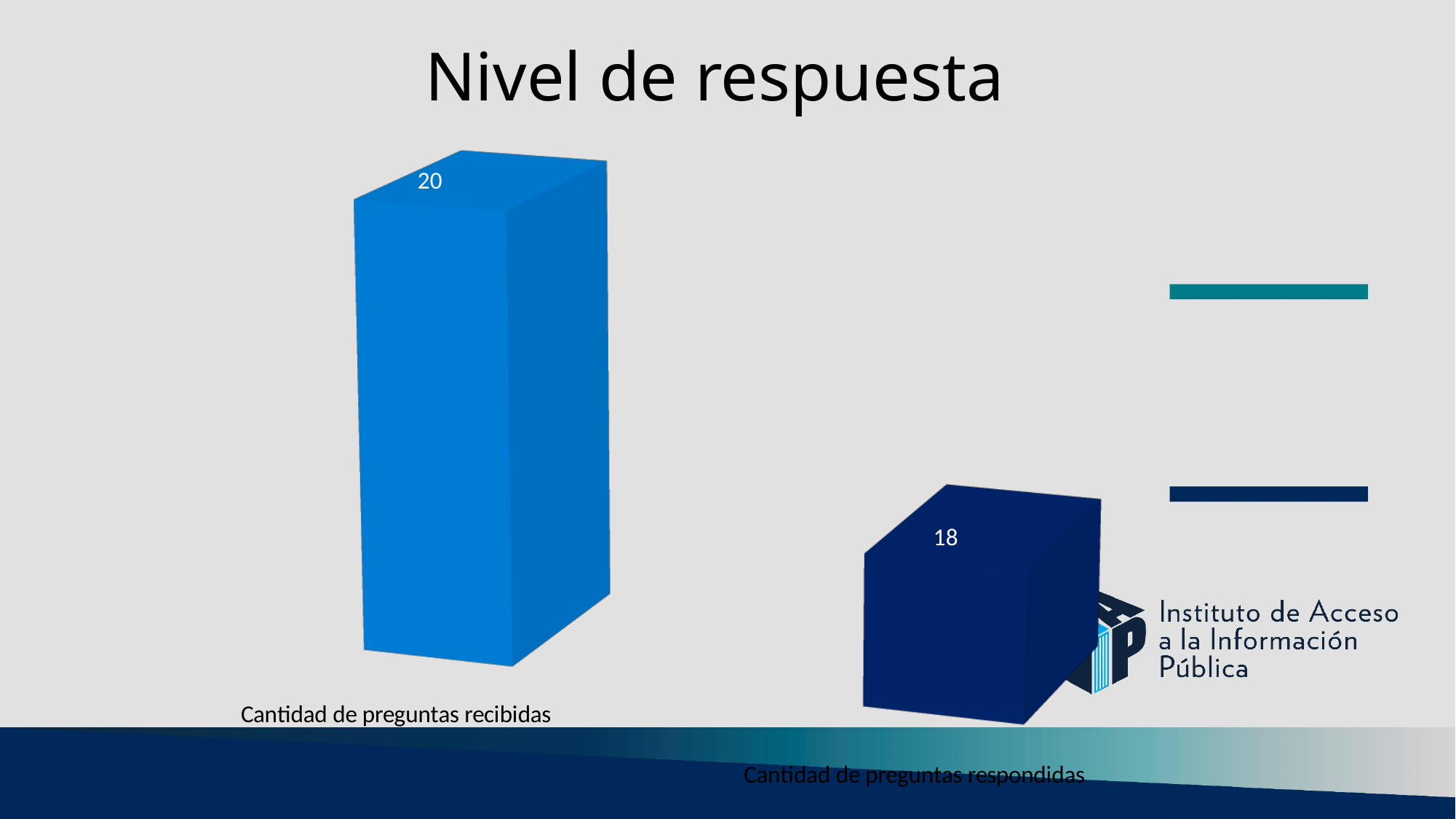
What is the value for Cantidad de preguntas recibidas? 20 Which category has the highest value? Cantidad de preguntas recibidas How many categories are shown in the chart? 2 Which category has the lowest value? Cantidad de preguntas respondidas What is the value for Cantidad de preguntas respondidas? 18 What is the difference between Cantidad de preguntas recibidas and Cantidad de preguntas respondidas? 2 Which is larger, Cantidad de preguntas recibidas or Cantidad de preguntas respondidas? Cantidad de preguntas recibidas What is the title of the chart? Nivel de respuesta What is the total of the two values shown in the chart? 38 What kind of chart is shown on the slide? Bar chart